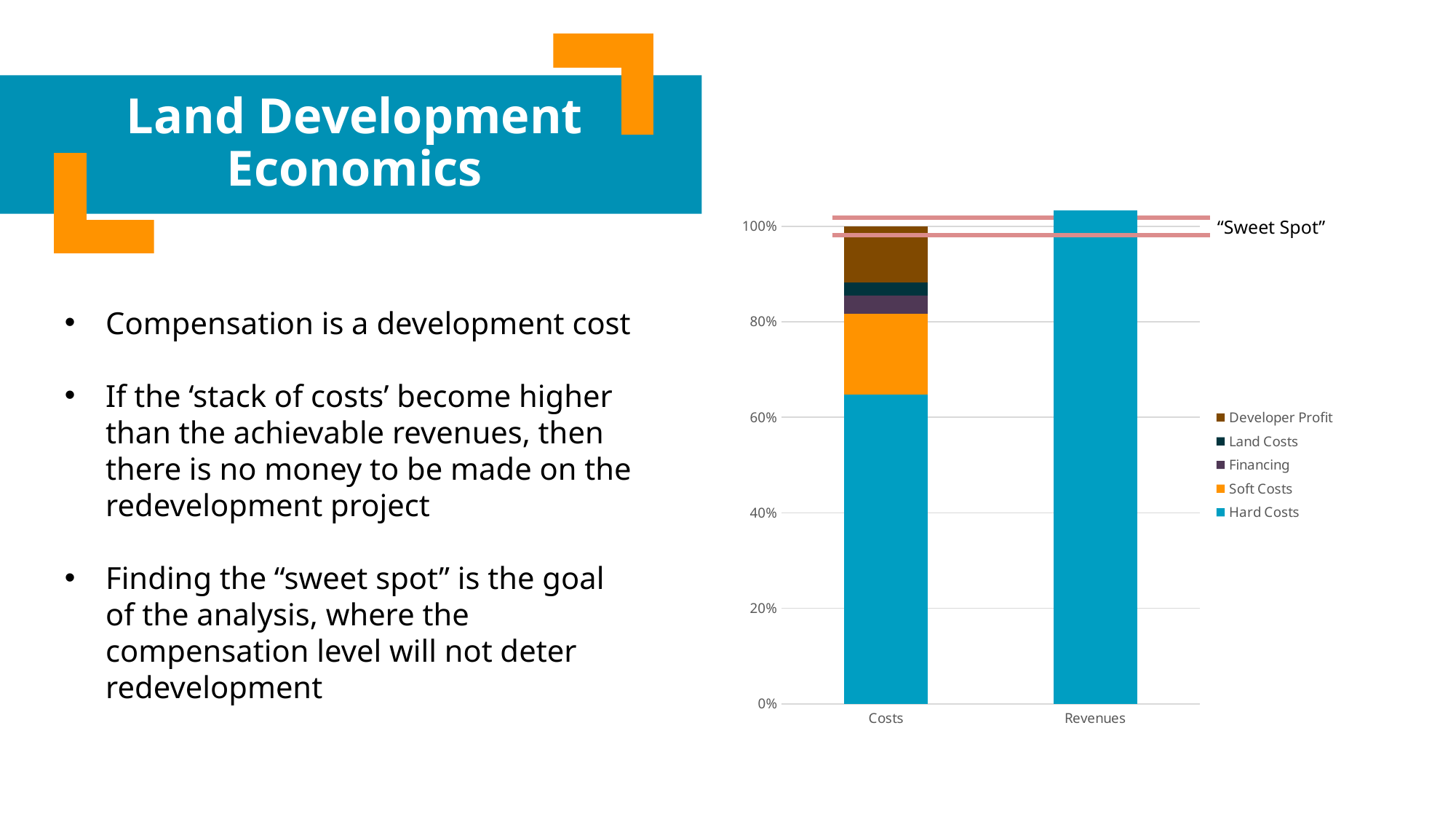
How many series does the chart legend list? 5 Which series appears at the bottom of the Costs stack? Hard Costs Is the Hard Costs segment of the Costs bar greater or less than 60%? greater Is the Revenues bar greater or less than 80%? greater Is the Developer Profit segment of the Costs bar greater or less than 20%? less Which series makes up the largest segment of the Costs bar? Hard Costs Which category's bar is made up of a single series? Revenues How many categories are shown on the x axis of the chart? 2 What kind of chart is shown on the slide? Stacked bar chart What label is written next to the horizontal lines near the top of the chart? "Sweet Spot"